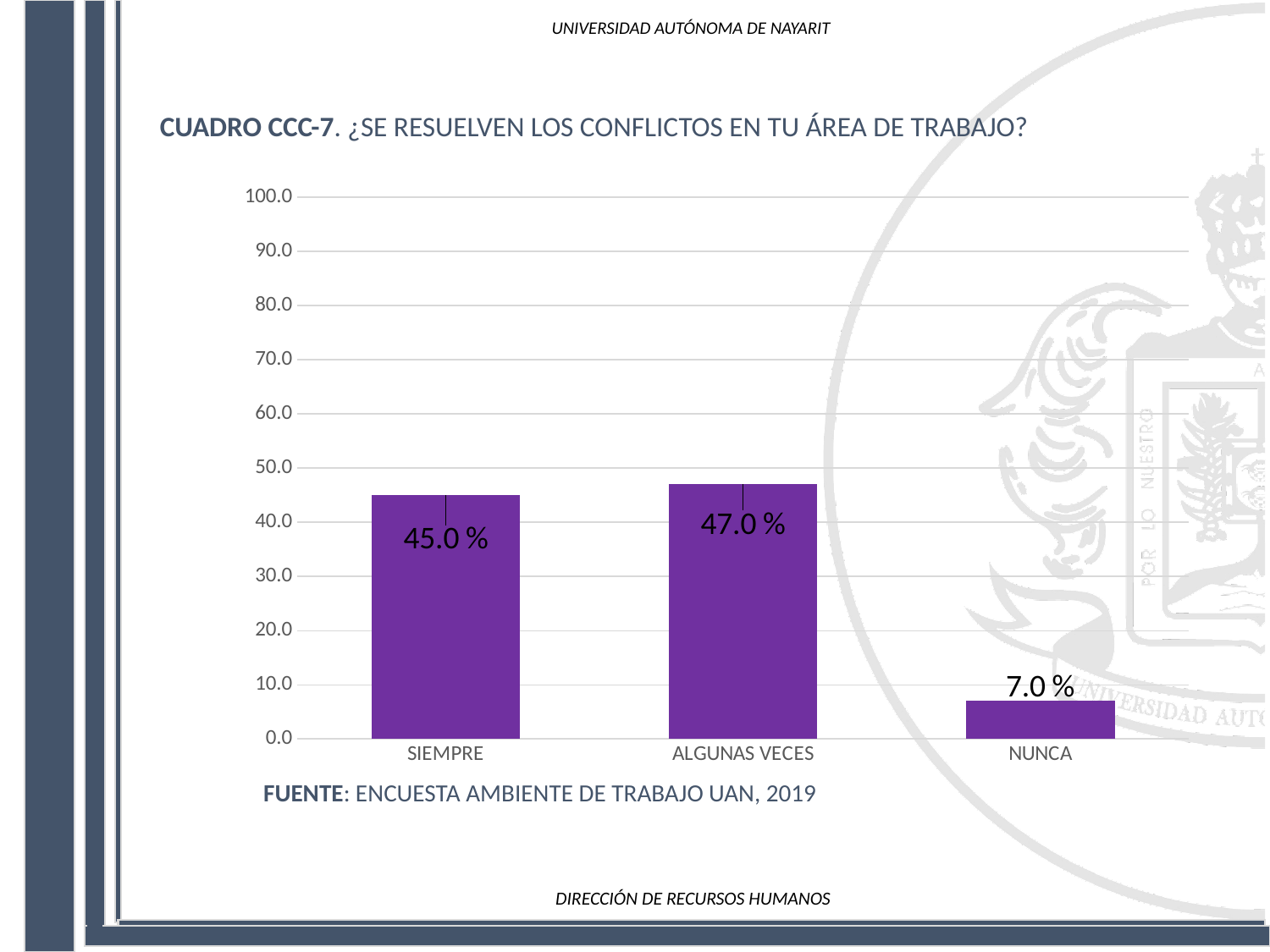
What is the difference between the values for SIEMPRE and NUNCA? 38.0 % What is the difference between the values for ALGUNAS VECES and SIEMPRE? 2.0 % What kind of chart is shown on the slide? bar chart What is the value for NUNCA? 7.0 % Which category has the lowest value? NUNCA What is the value for ALGUNAS VECES? 47.0 % How many categories are shown on the x axis? 3 Is the value for NUNCA greater or less than 10.0? less Which category has the highest value? ALGUNAS VECES What is the source cited below the chart? ENCUESTA AMBIENTE DE TRABAJO UAN, 2019 What is the value for SIEMPRE? 45.0 % Which is larger, the value for SIEMPRE or the value for NUNCA? SIEMPRE